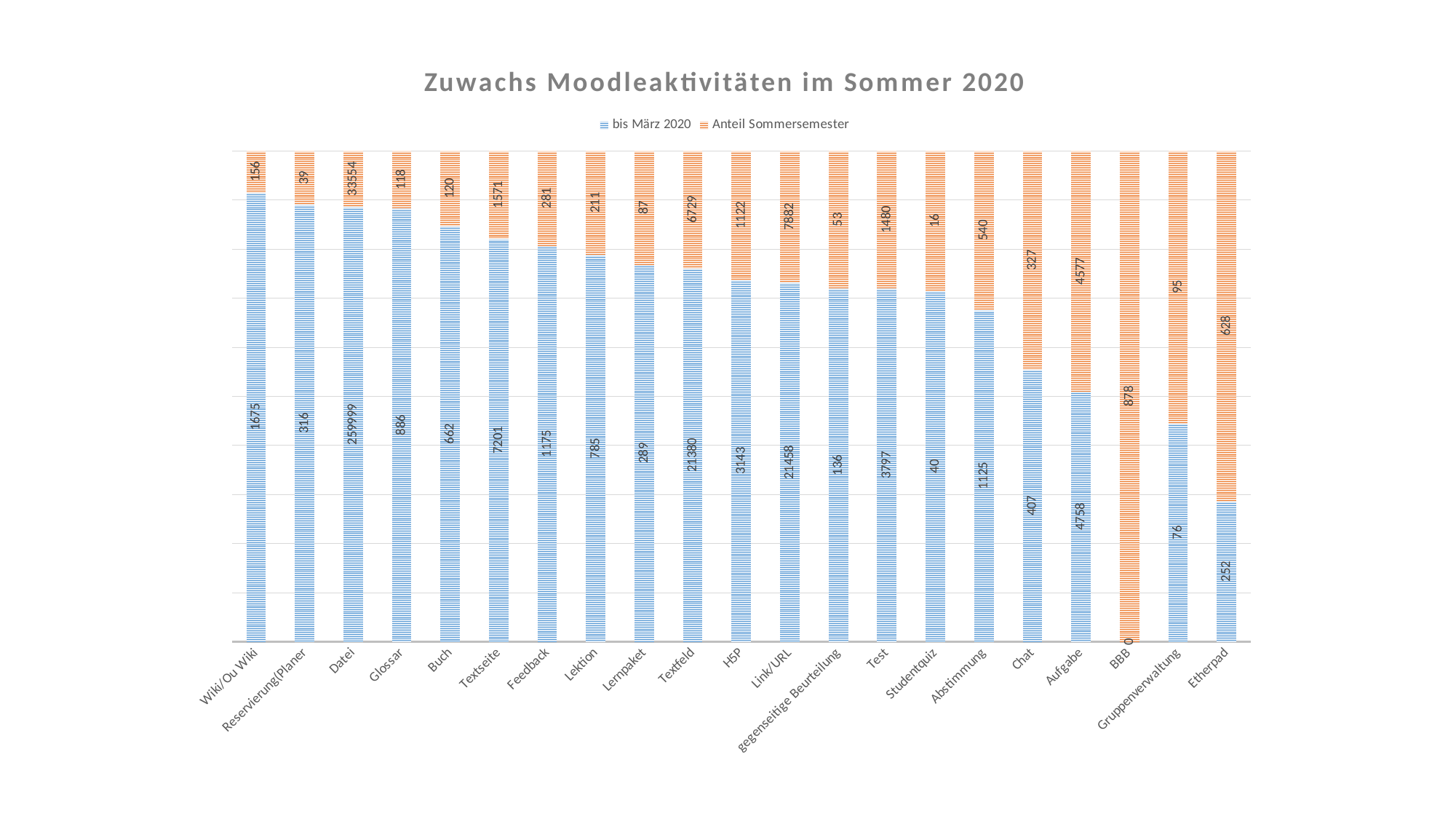
How many series does the legend list? 2 How many categories are shown on the x axis? 21 What is the 'Anteil Sommersemester' value for Link/URL? 7882 What is the total of the two series for Etherpad? 880 What is the title of the chart? Zuwachs Moodleaktivitäten im Sommer 2020 Which category has the highest 'Anteil Sommersemester' value? Datei What is the 'bis März 2020' value for Datei? 259999 What is the 'bis März 2020' value for BBB? 0 Which is larger: the 'Anteil Sommersemester' value for Aufgabe or for Test? Aufgabe What kind of chart is shown on the slide? stacked bar chart What is the difference between the 'bis März 2020' value for Textfeld and for Link/URL? 78 Which category has the lowest 'Anteil Sommersemester' value? Studentquiz